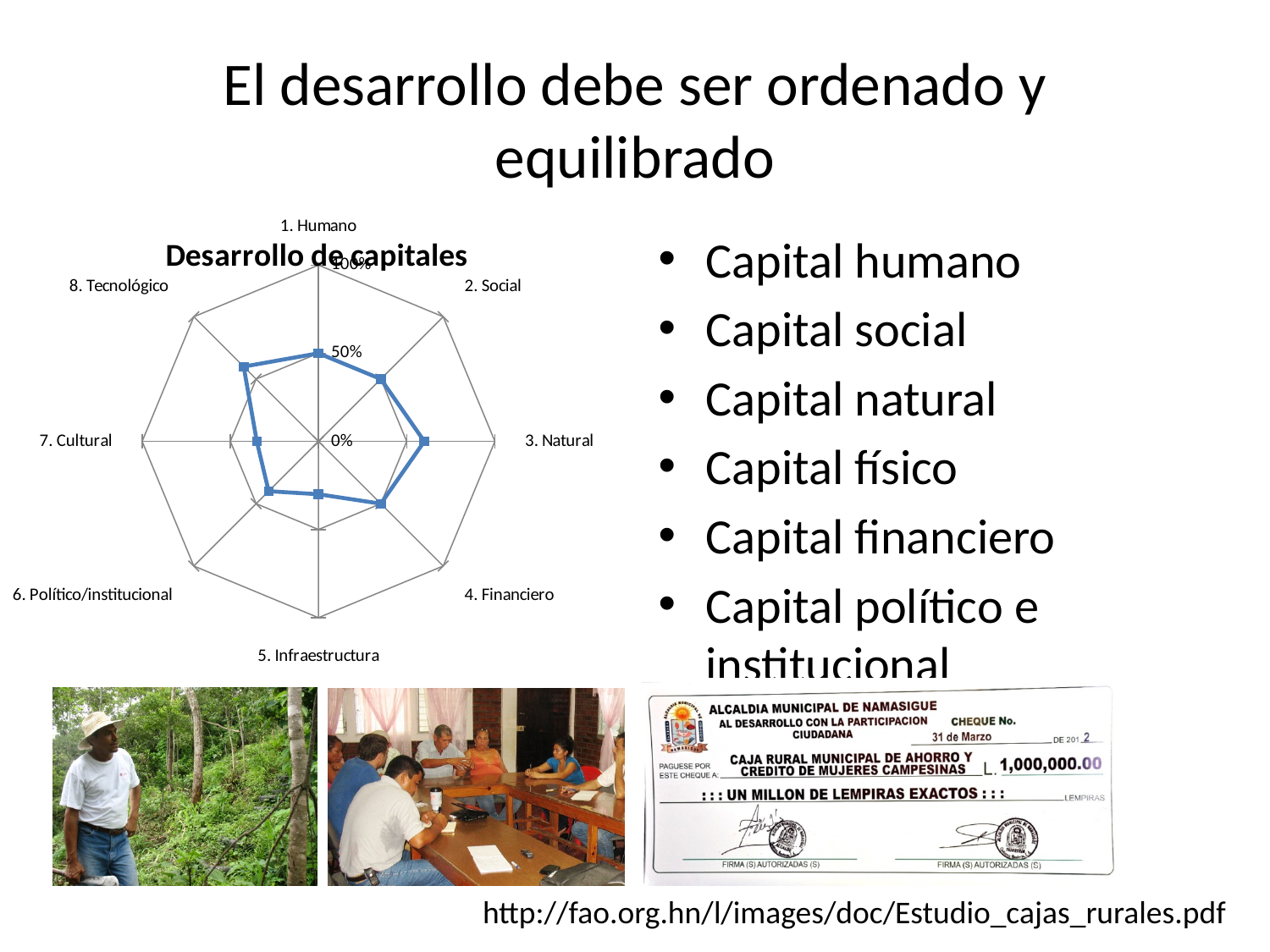
What is the title of the chart? Desarrollo de capitales Is the value for 7. Cultural greater or less than 50%? less Which has the larger value, 8. Tecnológico or 7. Cultural? 8. Tecnológico What type of chart is shown on the slide? Radar chart How many categories (axes) does the radar chart have? 8 Which has the larger value, 3. Natural or 5. Infraestructura? 3. Natural Is the value for 6. Político/institucional greater or less than 50%? less Is the value for 8. Tecnológico greater or less than 50%? greater What is the highest percentage tick shown on the chart's axis? 100%